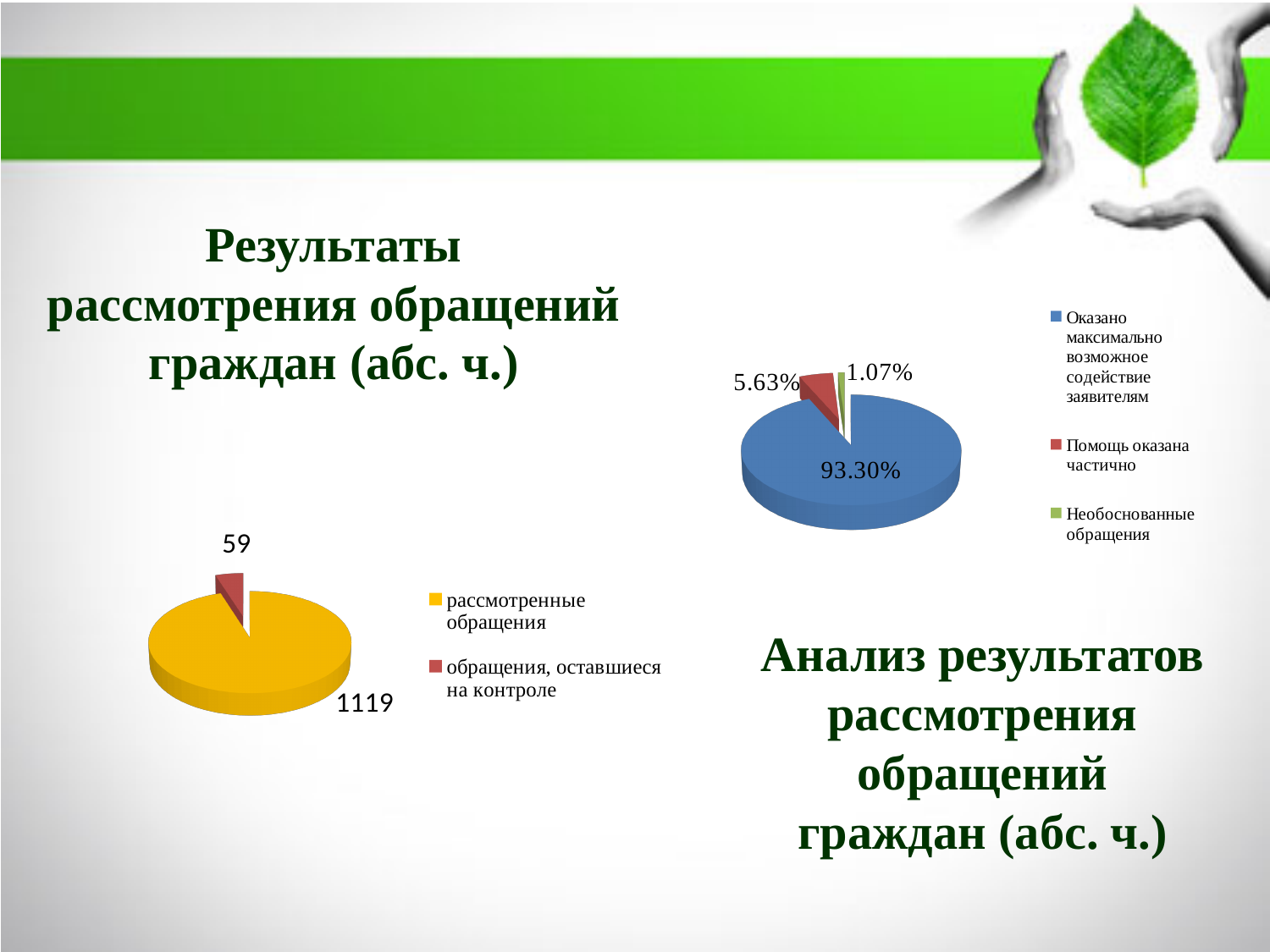
In the pie chart at the bottom left of the slide, which category has the larger value? рассмотренные обращения In the pie chart at the top right of the slide, what share is shown for "Оказано максимально возможное содействие заявителям"? 93.30% In the pie chart at the top right of the slide, what share is shown for "Помощь оказана частично"? 5.63% In the pie chart at the top right of the slide, which category has the smallest share? Необоснованные обращения How many categories does the legend of the pie chart at the top right of the slide list? 3 What type of chart is shown at the bottom left of the slide? Pie chart In the pie chart at the bottom left of the slide, what is the value for "рассмотренные обращения"? 1119 In the pie chart at the bottom left of the slide, what is the difference between the two slice values? 1060 In the pie chart at the bottom left of the slide, what is the value for "обращения, оставшиеся на контроле"? 59 In the pie chart at the top right of the slide, what colour is the slice for "Помощь оказана частично"? Red In the pie chart at the bottom left of the slide, what is the total of the two slices? 1178 In the pie chart at the top right of the slide, what share is shown for "Необоснованные обращения"? 1.07%